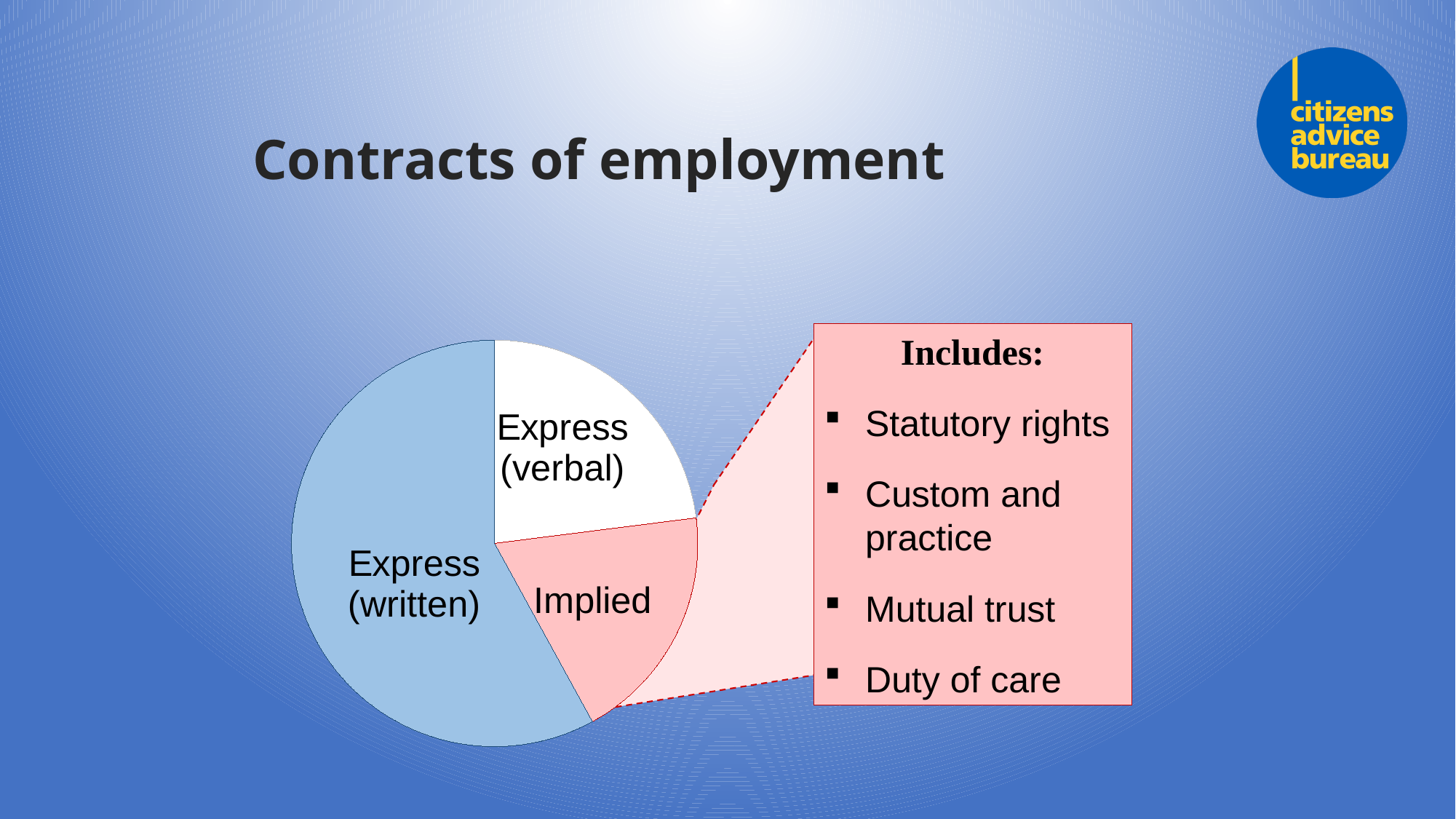
How many slices does the pie chart have? 3 Does the Express (written) slice take up more or less than half of the pie? more Which slice of the pie chart is the smallest? Implied Which slice is larger, Express (verbal) or Implied? Express (verbal) Which slice of the pie chart is linked to the callout box listing Statutory rights, Custom and practice, Mutual trust and Duty of care? Implied Which slice is larger, Express (written) or Express (verbal)? Express (written) What colour is the Implied slice of the pie chart? pink Which slice is larger, Express (written) or Implied? Express (written) Which slice of the pie chart is the largest? Express (written) What kind of chart is shown on the slide? pie chart